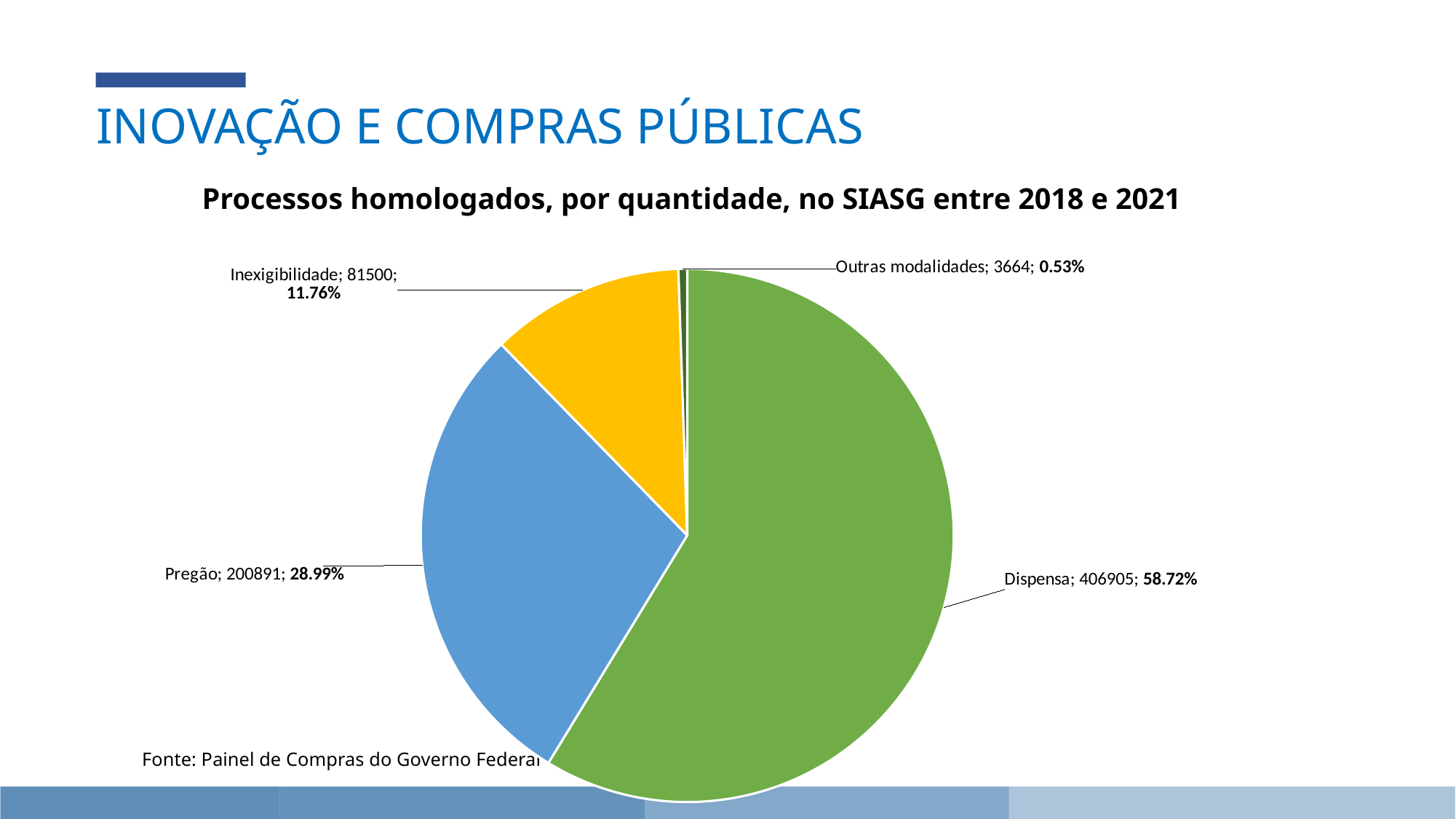
What share of the pie does Dispensa represent? 58.72% What is the value for Dispensa? 406905 What is the difference between the values for Dispensa and Pregão? 206014 What type of chart is shown on the slide? Pie chart Which category has the largest slice? Dispensa What is the value for Pregão? 200891 What is the value for Inexigibilidade? 81500 How many slices does the pie chart have? 4 What is the title of the chart? Processos homologados, por quantidade, no SIASG entre 2018 e 2021 What is the value for Outras modalidades? 3664 Which category has the smallest slice? Outras modalidades What share of the pie does Pregão represent? 28.99%